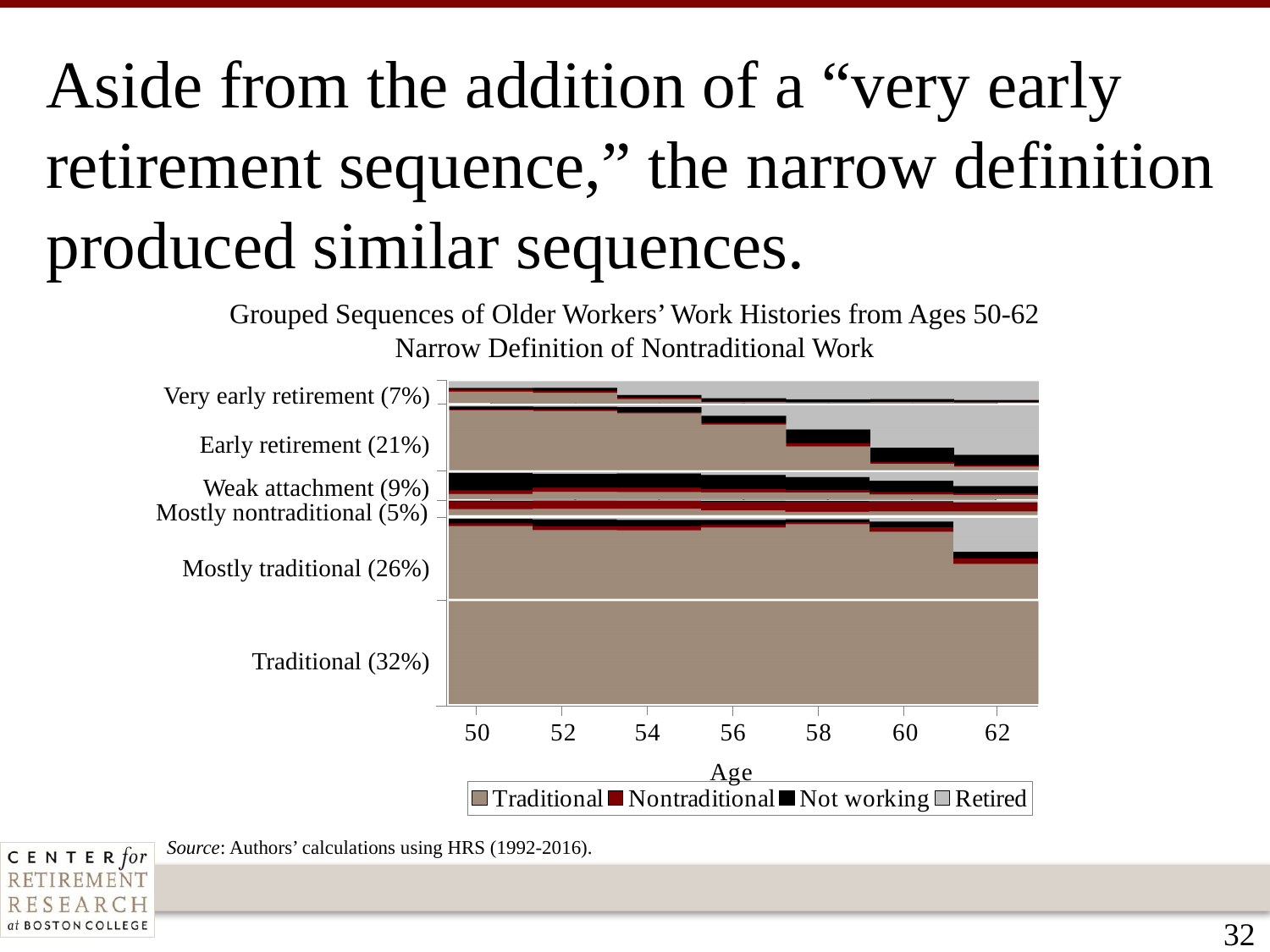
What percentage is shown for the Early retirement group? 21% How many percentage points larger is the Traditional group than the Mostly traditional group? 6 percentage points Which legend entry is shown in black? Not working How many work-status categories does the legend list? 4 Which sequence group has the smallest share of workers? Mostly nontraditional (5%) Which group is larger, Early retirement or Weak attachment? Early retirement What is the label of the horizontal axis? Age What do the percentages of all six sequence groups add up to? 100% In the Early retirement group, does the Retired share rise or fall as age increases from 50 to 62? rises Which sequence group has the largest share of workers? Traditional (32%) What percentage of older workers fall into the Traditional sequence group? 32% How many sequence groups are listed on the vertical axis? 6